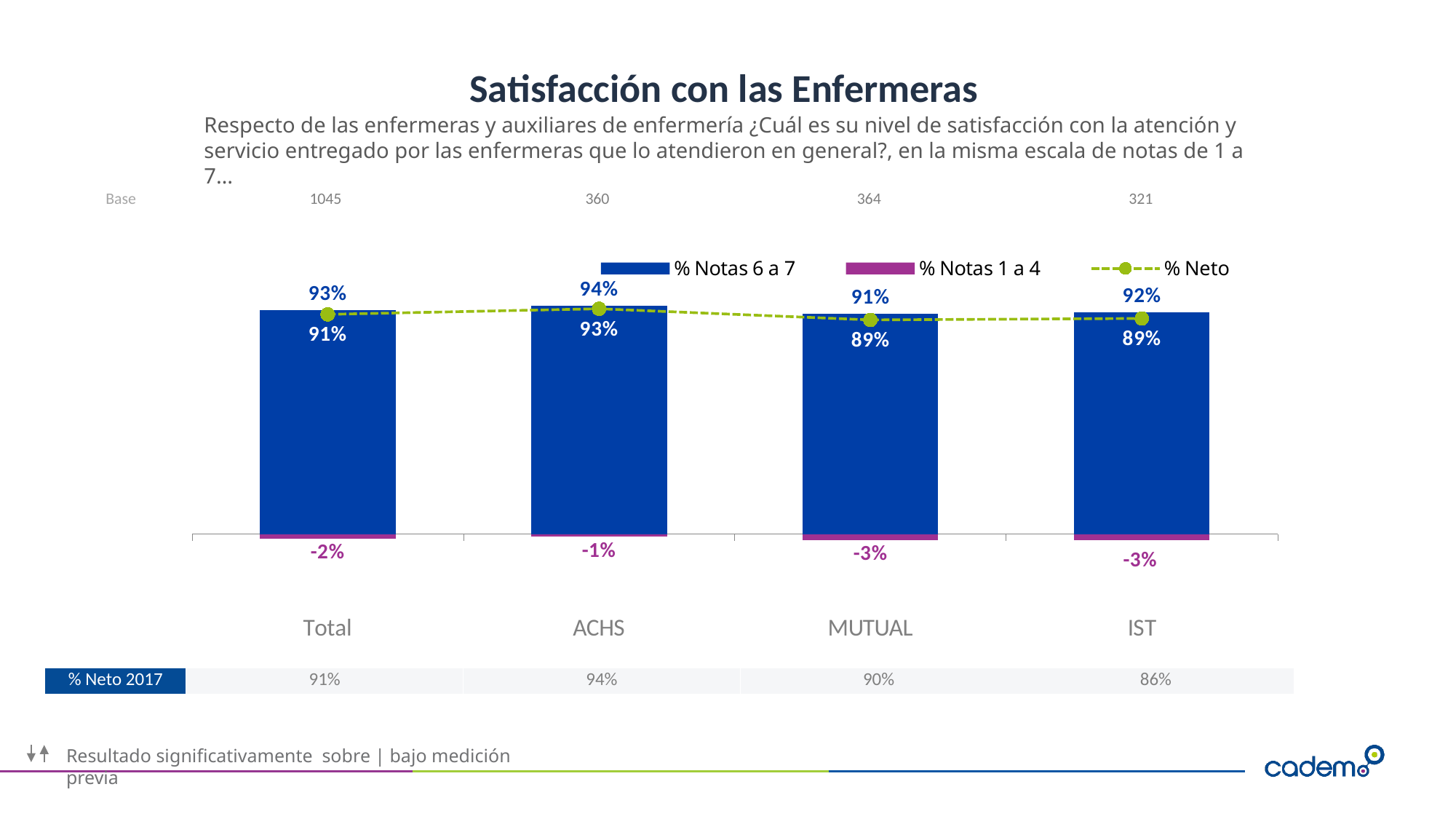
What kind of chart is this? Bar chart with a line Which category has the lowest % Notas 6 a 7 value? MUTUAL What is the % Neto value for IST? 89% What is the title of the chart? Satisfacción con las Enfermeras What is the % Notas 1 a 4 value for MUTUAL? -3% Which category has the highest % Notas 6 a 7 value? ACHS Which is larger, the % Neto value for ACHS or for MUTUAL? ACHS How many categories are shown on the x axis? 4 What is the % Notas 6 a 7 value for ACHS? 94% What is the difference between the % Notas 6 a 7 values for ACHS and MUTUAL? 3% How many series does the legend list? 3 What is the % Neto value for Total? 91%